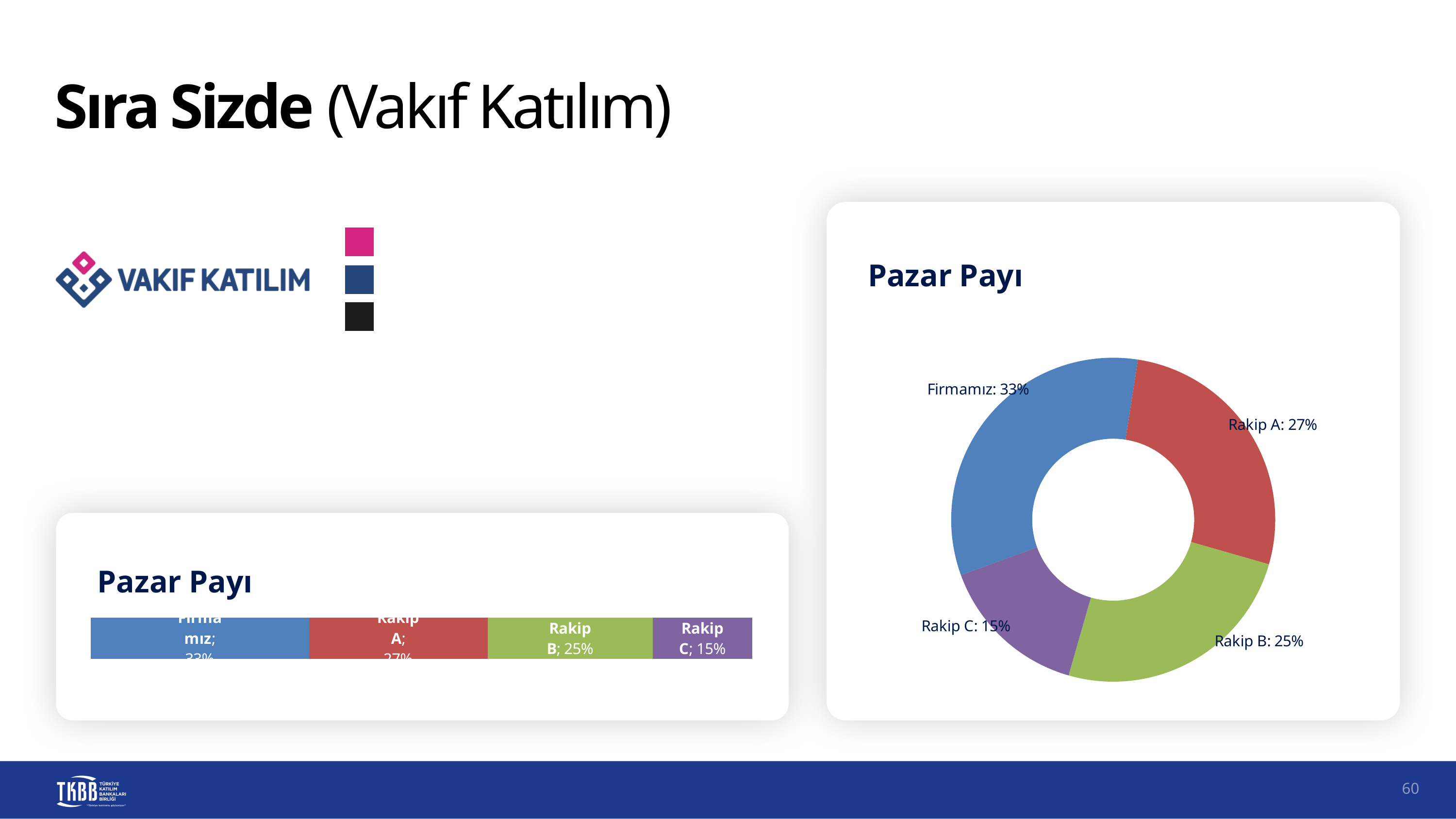
In the stacked bar chart on the left, what is the value for Rakip C? 15% How many categories are shown in the doughnut chart on the right? 4 In the doughnut chart on the right, which category has the largest share? Firmamız In the doughnut chart on the right, which is larger, the share of Rakip B or Rakip C? Rakip B What kind of chart is the chart in the bottom-left panel of the slide? Stacked bar chart In the doughnut chart on the right, which category has the smallest share? Rakip C In the doughnut chart on the right, what is the share for Rakip A? 27% In the stacked bar chart on the left, what is the value for Rakip B? 25% In the doughnut chart on the right, what is the difference between the shares of Rakip A and Rakip C? 12% What is the title of the doughnut chart on the right? Pazar Payı In the doughnut chart on the right, what is the share for Firmamız? 33% What kind of chart is the chart on the right of the slide? Doughnut chart